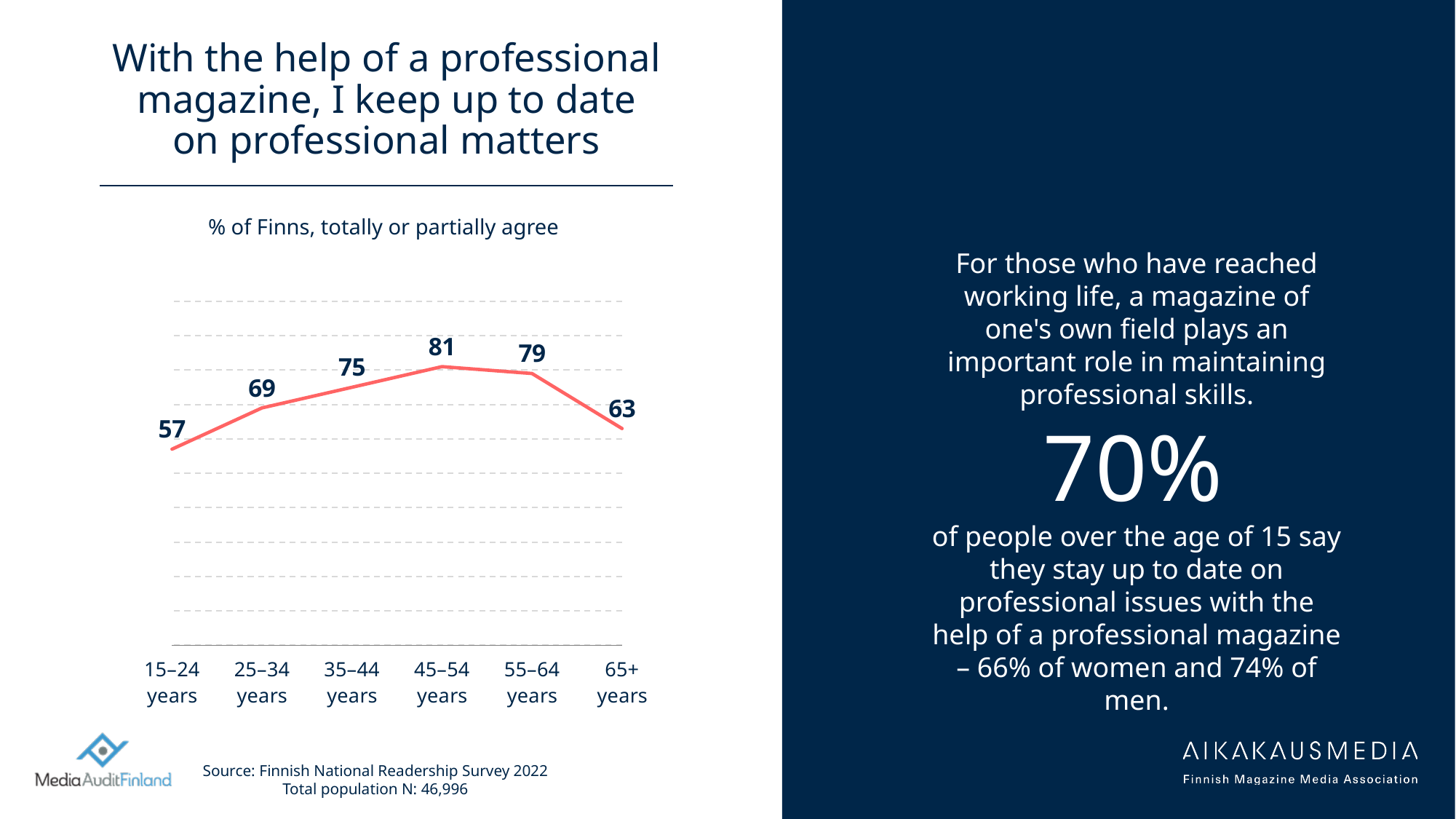
What kind of chart is shown on the slide? Line chart What is the value for the 65+ years age group? 63 Do the values rise or fall from 15–24 years to 45–54 years? Rise What is the value for the 45–54 years age group? 81 What is the difference between the values for 45–54 years and 15–24 years? 24 How many age groups are plotted on the chart? 6 What is the difference between the values for 55–64 years and 65+ years? 16 What is the subtitle shown above the chart? % of Finns, totally or partially agree What is the value for the 15–24 years age group? 57 Which is larger, the value for 25–34 years or the value for 65+ years? 25–34 years Which age group has the lowest value? 15–24 years Which age group has the highest value? 45–54 years